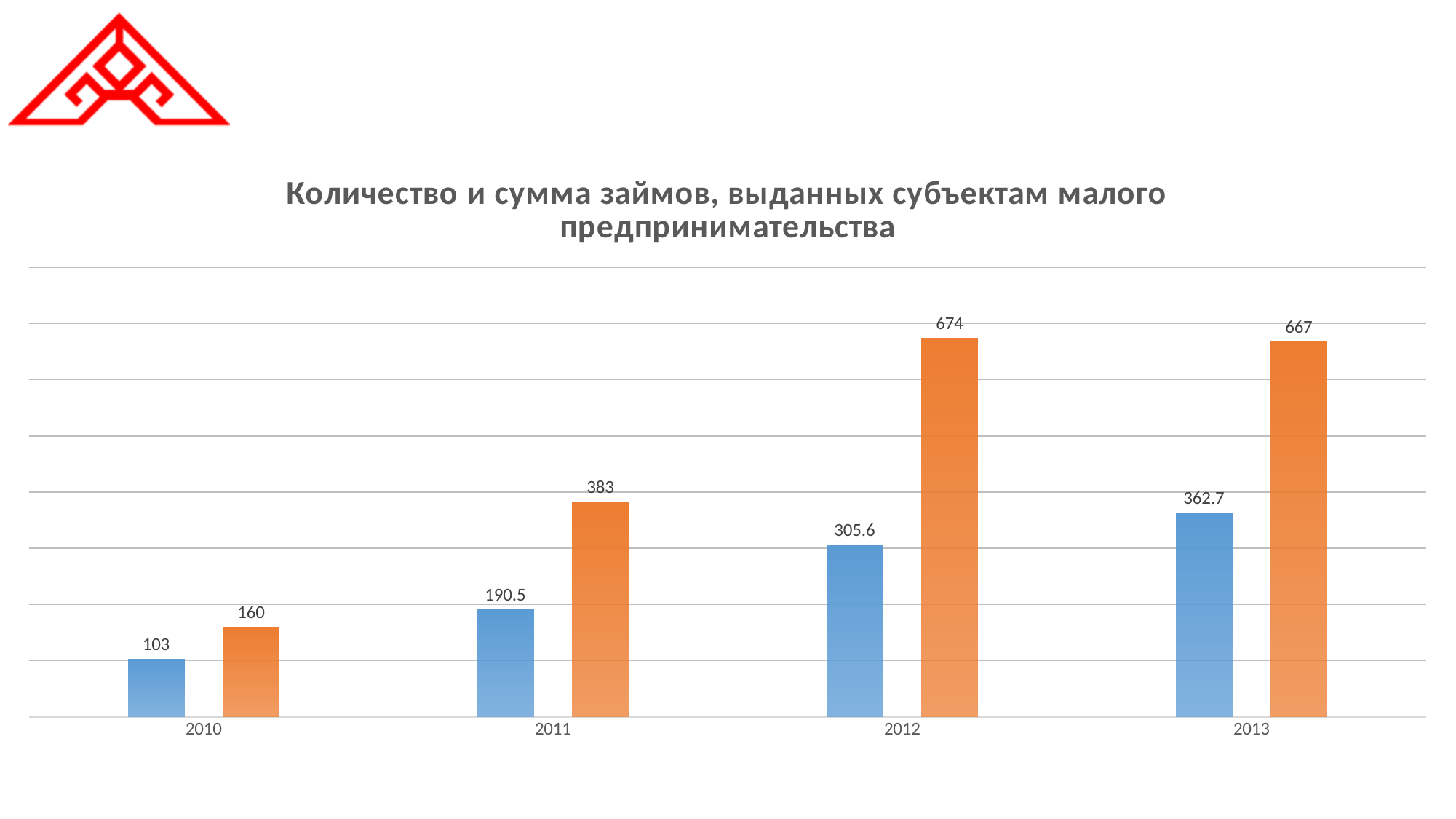
What is the value of the orange bar for 2013? 667 What is the difference between the orange bar values for 2012 and 2011? 291 Which is larger, the blue bar for 2013 or the blue bar for 2012? 2013 In which year is the blue bar lowest? 2010 What is the value of the blue bar for 2010? 103 What is the value of the orange bar for 2011? 383 How many years are shown on the x axis of the chart? 4 What is the title of the chart? Количество и сумма займов, выданных субъектам малого предпринимательства In which year is the orange bar highest? 2012 What is the value of the blue bar for 2012? 305.6 What type of chart is shown on the slide? bar chart Do the blue bar values rise or fall from 2010 to 2013? rise